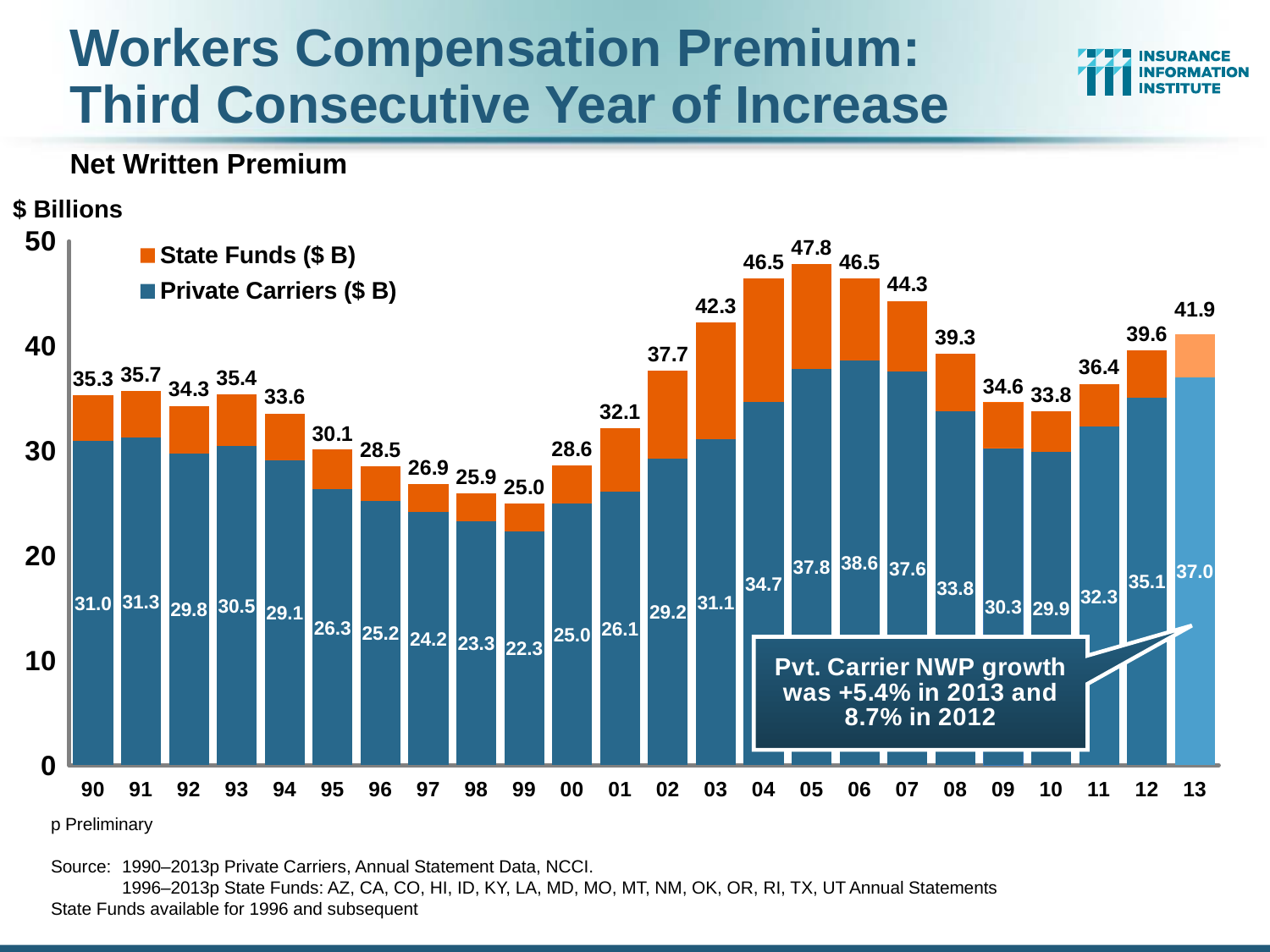
How many series does the legend list? 2 Which year had the lowest total net written premium? 99 Did the total net written premium rise or fall from 2010 to 2013? Rise By how much did the total net written premium increase from 2012 to 2013? 2.3 Which year had the highest total net written premium? 05 How many years are shown on the x axis of the chart? 24 What was the State Funds portion of net written premium in 2013 (total minus Private Carriers)? 4.9 What kind of chart is shown on the slide? Stacked bar chart What was the Private Carriers net written premium in 2013? 37.0 Which year had the highest Private Carriers net written premium? 06 Which year had a higher total net written premium, 2003 or 2008? 03 What was the total net written premium in 2005? 47.8